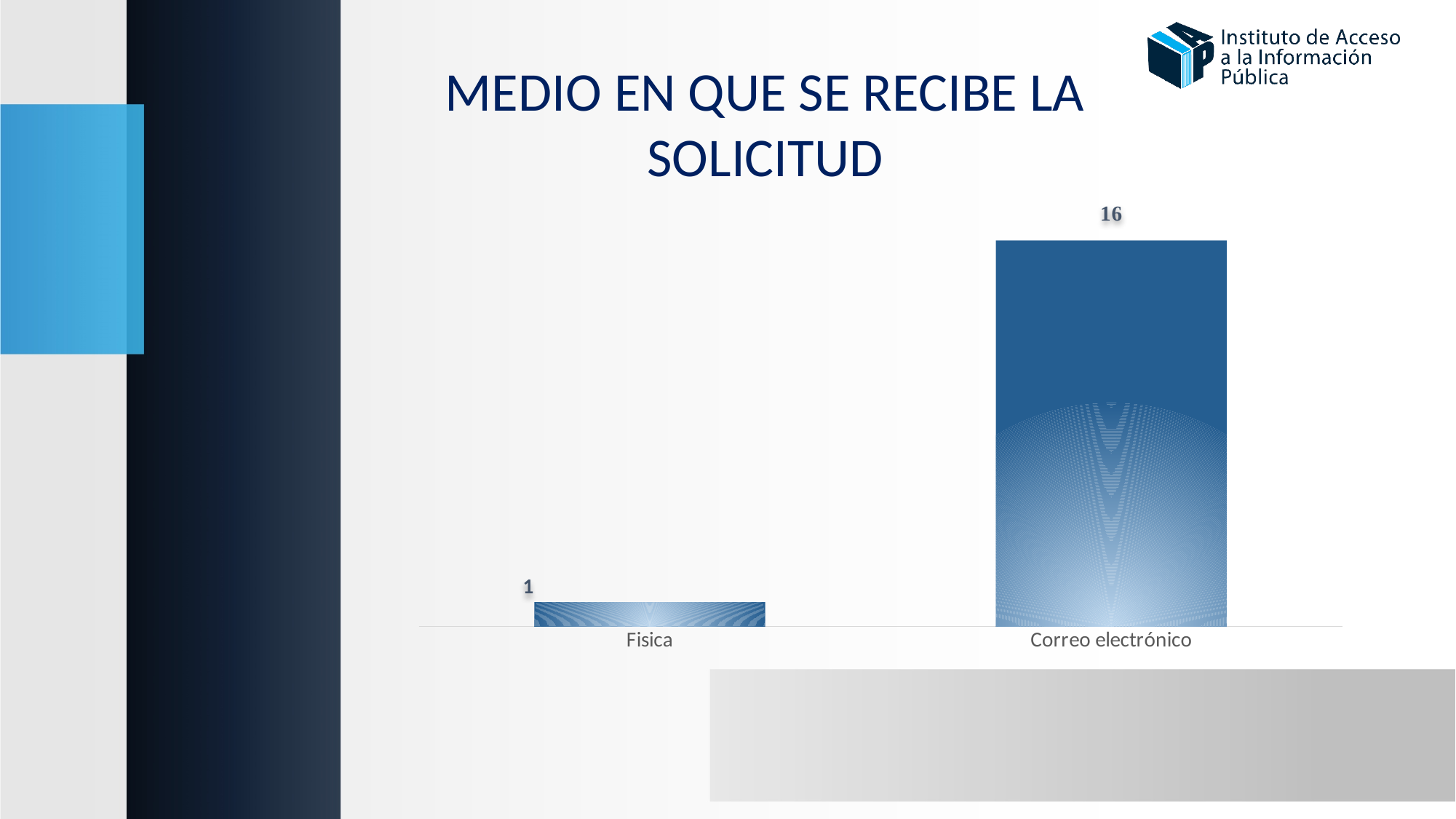
What is the total of the values for Fisica and Correo electrónico? 17 Which category has the lowest value? Fisica Do the values rise or fall from Fisica to Correo electrónico along the x axis? Rise What is the difference between the values for Correo electrónico and Fisica? 15 What is the title of the slide containing the chart? MEDIO EN QUE SE RECIBE LA SOLICITUD Which is larger, the value for Fisica or the value for Correo electrónico? Correo electrónico Which category has the highest value? Correo electrónico What is the value for Correo electrónico? 16 What is the value for Fisica? 1 What kind of chart is shown on the slide? Bar chart How many categories are shown in the chart? 2